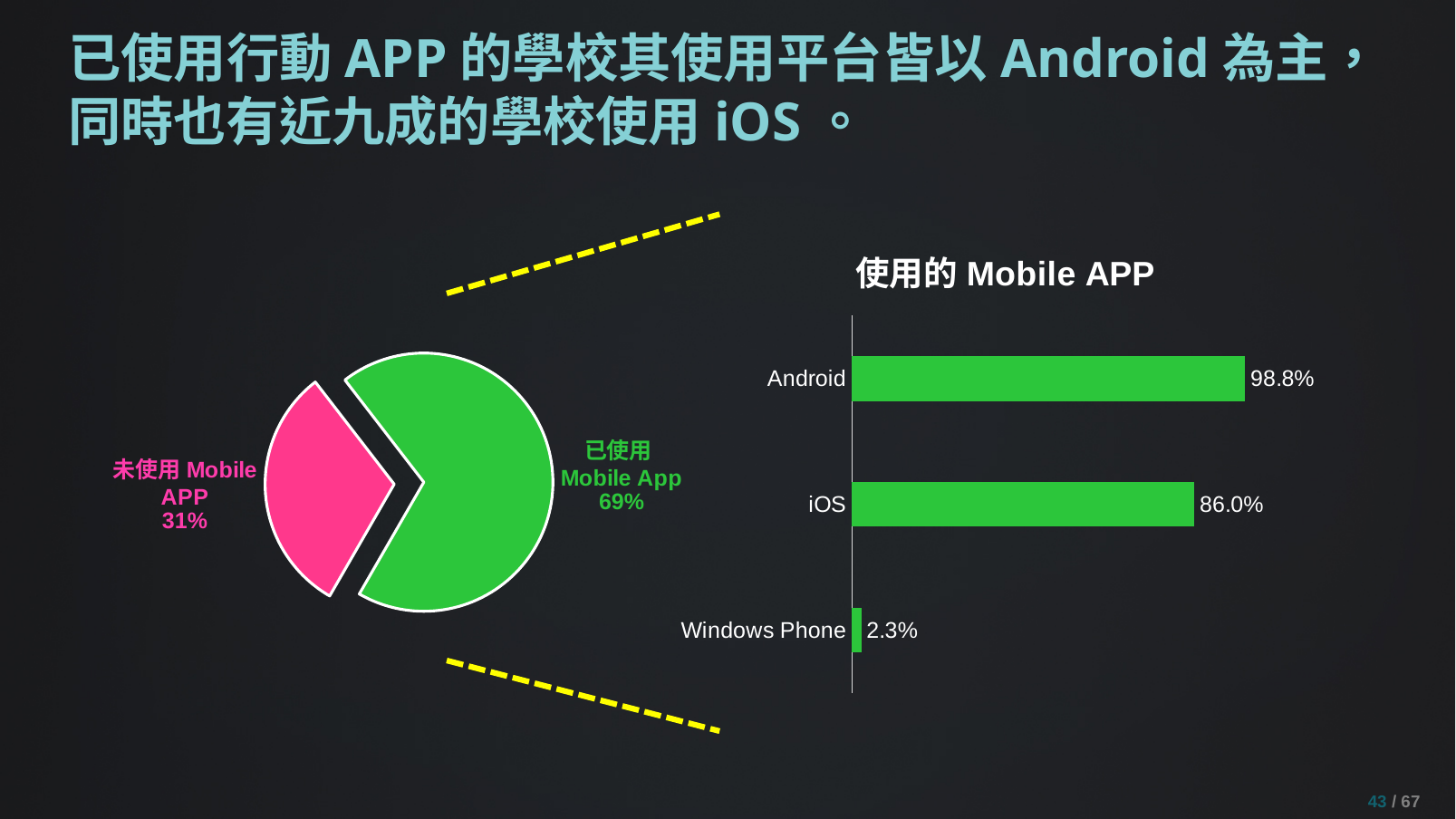
In the chart titled 使用的 Mobile APP, what is the value for Windows Phone? 2.3% In the pie chart on the left, what share of schools have used a Mobile App (已使用 Mobile App)? 69% In the chart titled 使用的 Mobile APP, what is the difference between the Android and iOS values? 12.8% In the pie chart on the left, what share of schools have not used a Mobile App (未使用 Mobile APP)? 31% In the chart titled 使用的 Mobile APP, which platform has the highest value? Android In the chart titled 使用的 Mobile APP, what is the value for Android? 98.8% What kind of chart is the chart titled 使用的 Mobile APP? Bar chart How many slices does the pie chart on the left have? 2 What kind of chart is the chart on the left of the slide? Pie chart In the pie chart on the left, which slice is larger: 已使用 Mobile App or 未使用 Mobile APP? 已使用 Mobile App In the chart titled 使用的 Mobile APP, what is the value for iOS? 86.0% In the chart titled 使用的 Mobile APP, which platform has the lowest value? Windows Phone